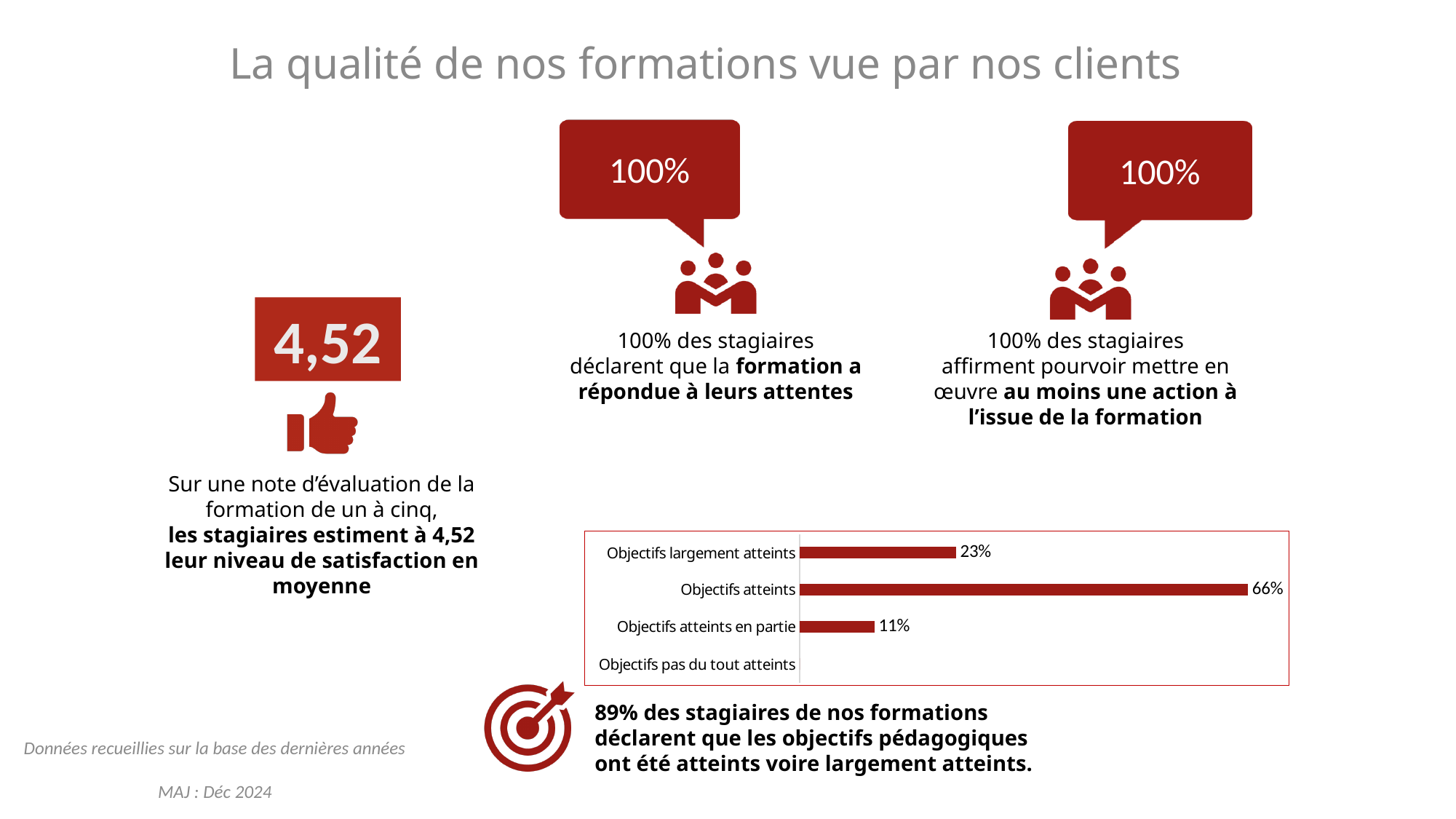
What is the value for "Objectifs atteints en partie" in the bar chart? 11% Which is larger in the bar chart: "Objectifs largement atteints" or "Objectifs atteints en partie"? Objectifs largement atteints What kind of chart is shown on the slide? Bar chart What is the value for "Objectifs largement atteints" in the bar chart? 23% What is the difference between the values for "Objectifs atteints" and "Objectifs largement atteints"? 43 percentage points What is the value for "Objectifs atteints" in the bar chart? 66% Which category is listed first (at the top) in the bar chart? Objectifs largement atteints What is the difference between the values for "Objectifs largement atteints" and "Objectifs atteints en partie"? 12 percentage points How many categories are shown in the bar chart? 4 Which category has the highest value in the bar chart? Objectifs atteints What colour are the bars in the chart? Dark red What is the combined value of "Objectifs largement atteints" and "Objectifs atteints"? 89%